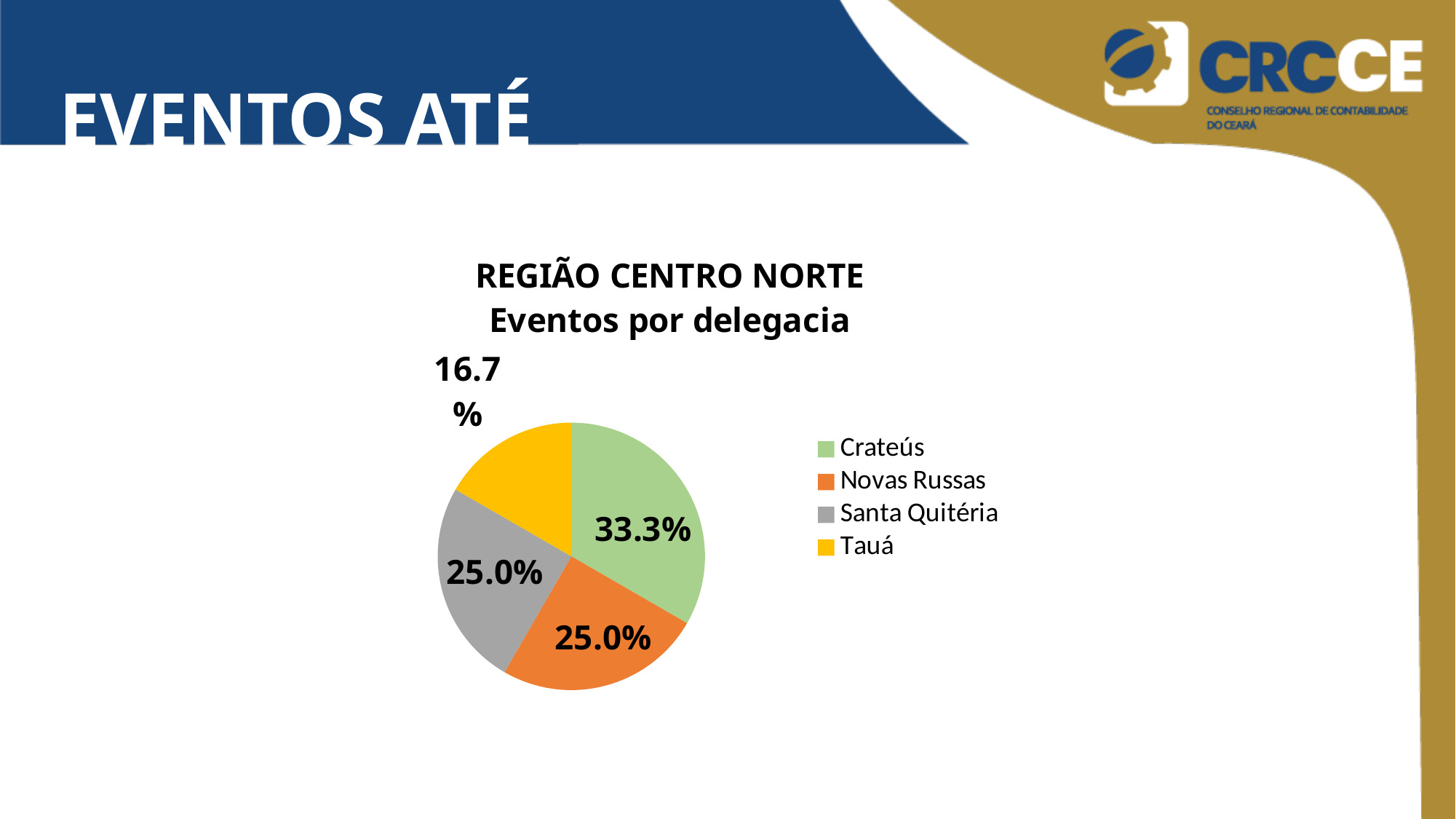
What is the title of the chart? REGIÃO CENTRO NORTE Eventos por delegacia Which has a larger share, Crateús or Santa Quitéria? Crateús What share of the pie does Crateús have? 33.3% What kind of chart is shown on the slide? pie chart Which delegacia has the largest share of events? Crateús Which colour represents Novas Russas in the legend? orange Which delegacia has the smallest share of events? Tauá What share of the pie does Tauá have? 16.7% How many delegacias are shown in the pie chart? 4 What share of the pie does Santa Quitéria have? 25.0% What is the difference in percentage points between the shares of Crateús and Tauá? 16.6